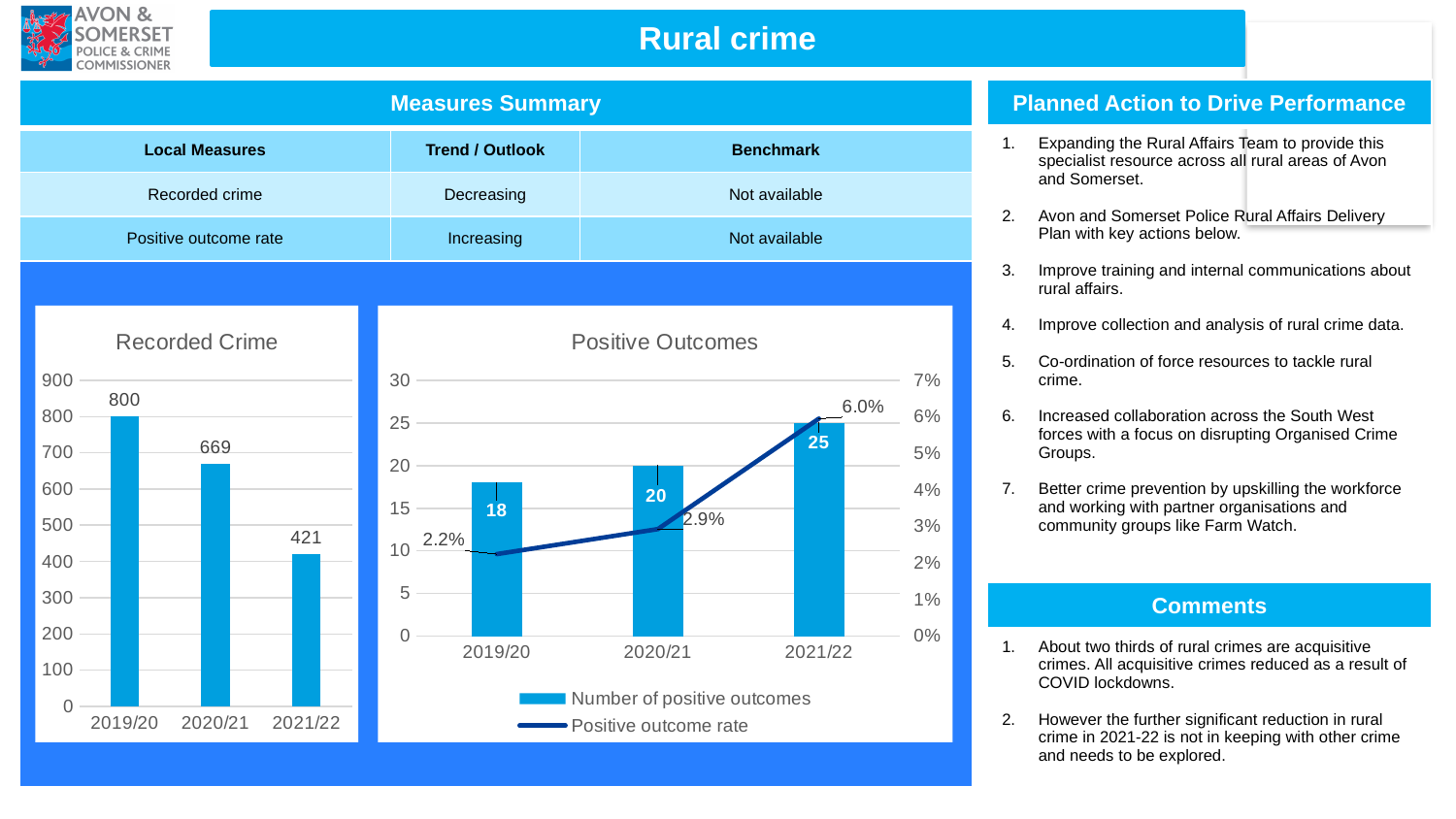
In the Positive Outcomes chart, is the positive outcome rate for 2019/20 larger or smaller than for 2020/21? smaller In the Recorded Crime chart, what is the difference between the 2019/20 and 2020/21 values? 131 In the Recorded Crime chart, what is the value for 2019/20? 800 In the Positive Outcomes chart, what is the positive outcome rate for 2021/22? 6.0% In the Recorded Crime chart, which year has the lowest recorded crime? 2021/22 What kind of chart is the Recorded Crime chart? bar chart In the Recorded Crime chart, how many years are shown? 3 In the Recorded Crime chart, what is the value for 2021/22? 421 In the Positive Outcomes chart, which year has the highest number of positive outcomes? 2021/22 In the Positive Outcomes chart, how many series does the legend list? 2 In the Recorded Crime chart, do the values rise or fall from 2019/20 to 2021/22? fall In the Positive Outcomes chart, what is the number of positive outcomes for 2020/21? 20